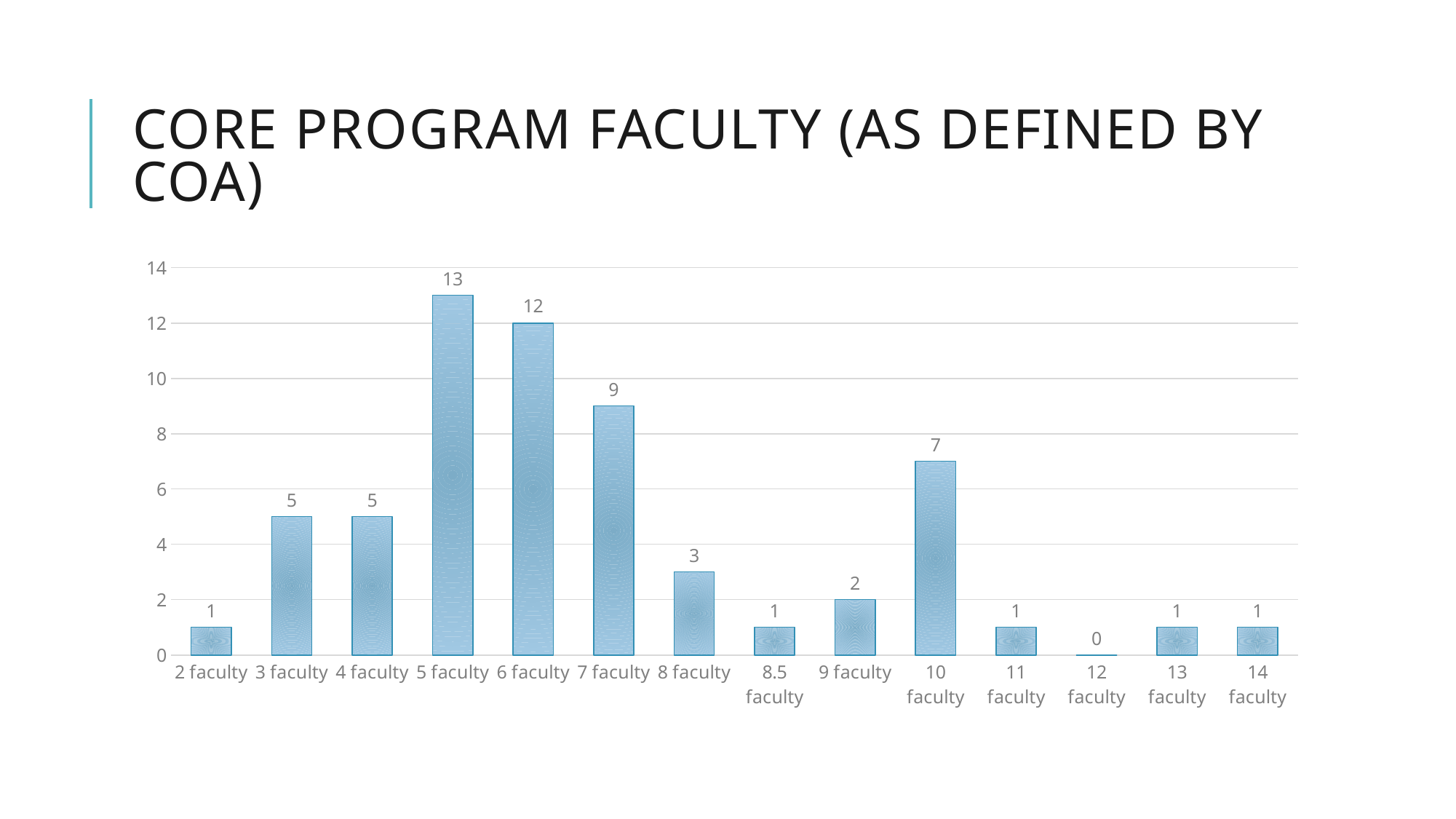
What is the value for 8.5 faculty? 1 What is the difference between the values for 7 faculty and 8 faculty? 6 What is the difference between the values for 5 faculty and 6 faculty? 1 What is the value for 5 faculty? 13 Which category has the highest value? 5 faculty Which category has the lowest value? 12 faculty What is the value for 10 faculty? 7 What kind of chart is shown on the slide? Bar chart How many categories are shown on the x axis? 14 What is the title of the slide? Core Program Faculty (as defined by COA) Which is larger, the value for 10 faculty or the value for 9 faculty? 10 faculty What is the value for 12 faculty? 0